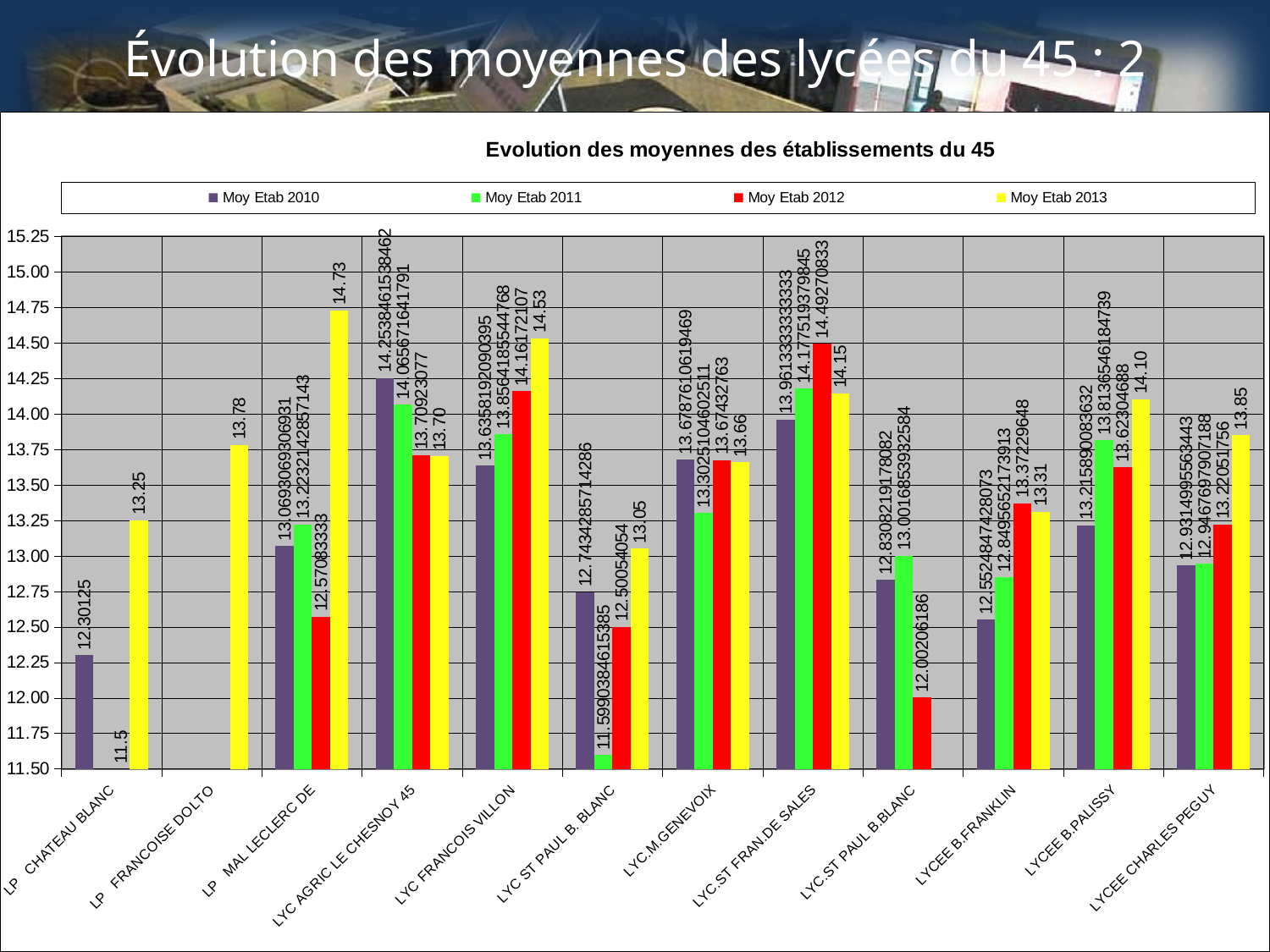
What is the Moy Etab 2013 value for LP MAL LECLERC DE? 14.73 What is the Moy Etab 2013 value for LYC FRANCOIS VILLON? 14.53 Which has the larger Moy Etab 2013 value, LYCEE B.PALISSY or LYCEE CHARLES PEGUY? LYCEE B.PALISSY What kind of chart is shown on the slide? bar chart How many series does the legend list? 4 Is the Moy Etab 2010 value for LYC AGRIC LE CHESNOY 45 greater or less than 14.00? greater Which establishment has the lowest Moy Etab 2013 value? LYC ST PAUL B. BLANC How many establishments (categories) are shown on the x axis? 12 What is the title of the chart? Evolution des moyennes des établissements du 45 What is the difference between the Moy Etab 2013 values of LP MAL LECLERC DE and LP FRANCOISE DOLTO? 0.95 Which establishment has the highest Moy Etab 2013 value? LP MAL LECLERC DE What is the Moy Etab 2012 value for LYCEE B.FRANKLIN? 13.37229648